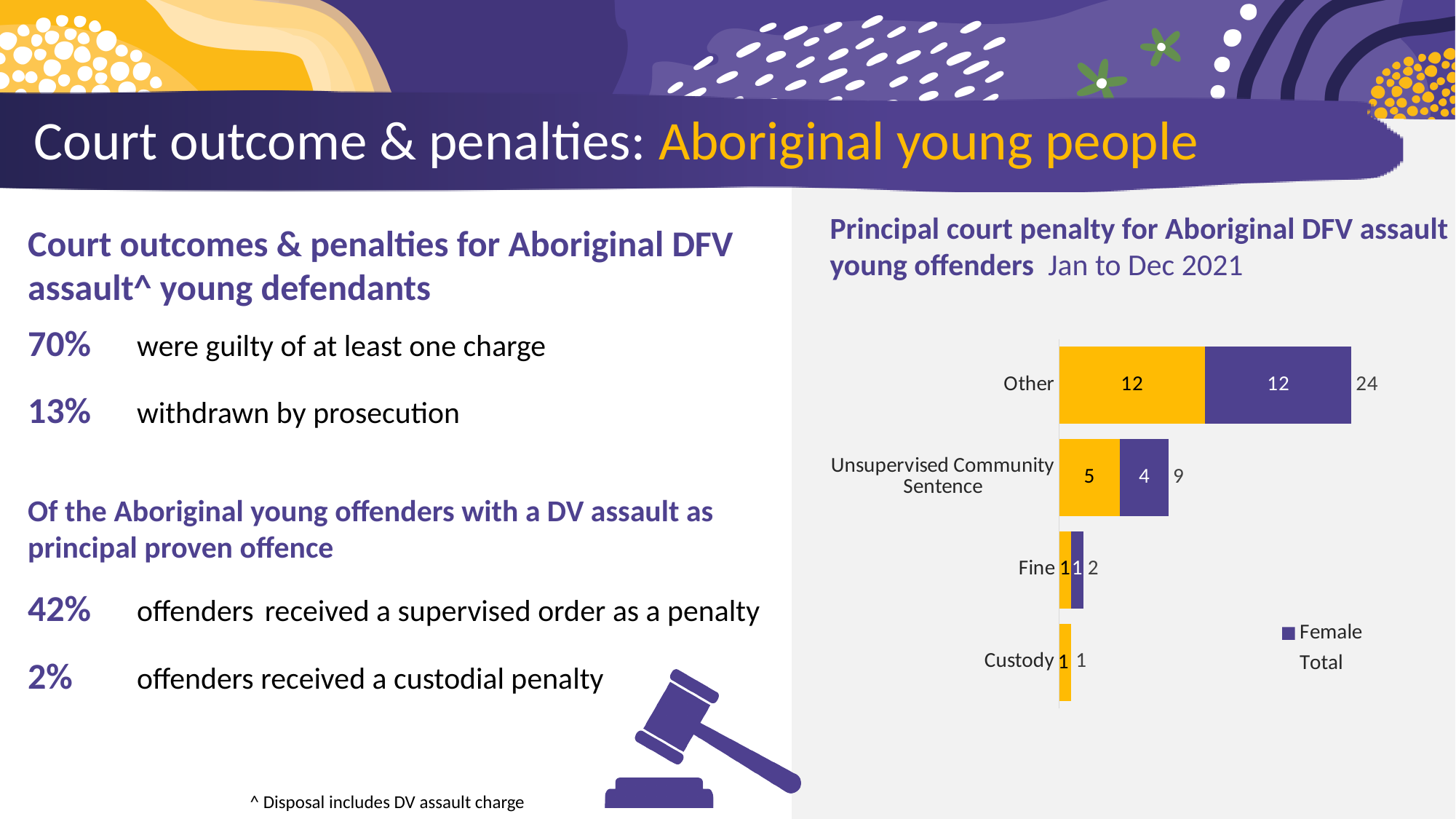
What kind of chart is shown on the slide? Bar chart How many penalty categories are shown in the chart? 4 What is the total for the Fine category? 2 Which penalty category has the lowest total? Custody What is the difference between the total for Other and the total for Unsupervised Community Sentence? 15 What is the Female value for Unsupervised Community Sentence? 4 What entries does the chart legend list? Female, Total Which has a larger Female value: Unsupervised Community Sentence or Fine? Unsupervised Community Sentence What is the total for Unsupervised Community Sentence? 9 What is the Female value for the Other category? 12 Which penalty category has the highest total? Other What time period does the chart title cover? Jan to Dec 2021